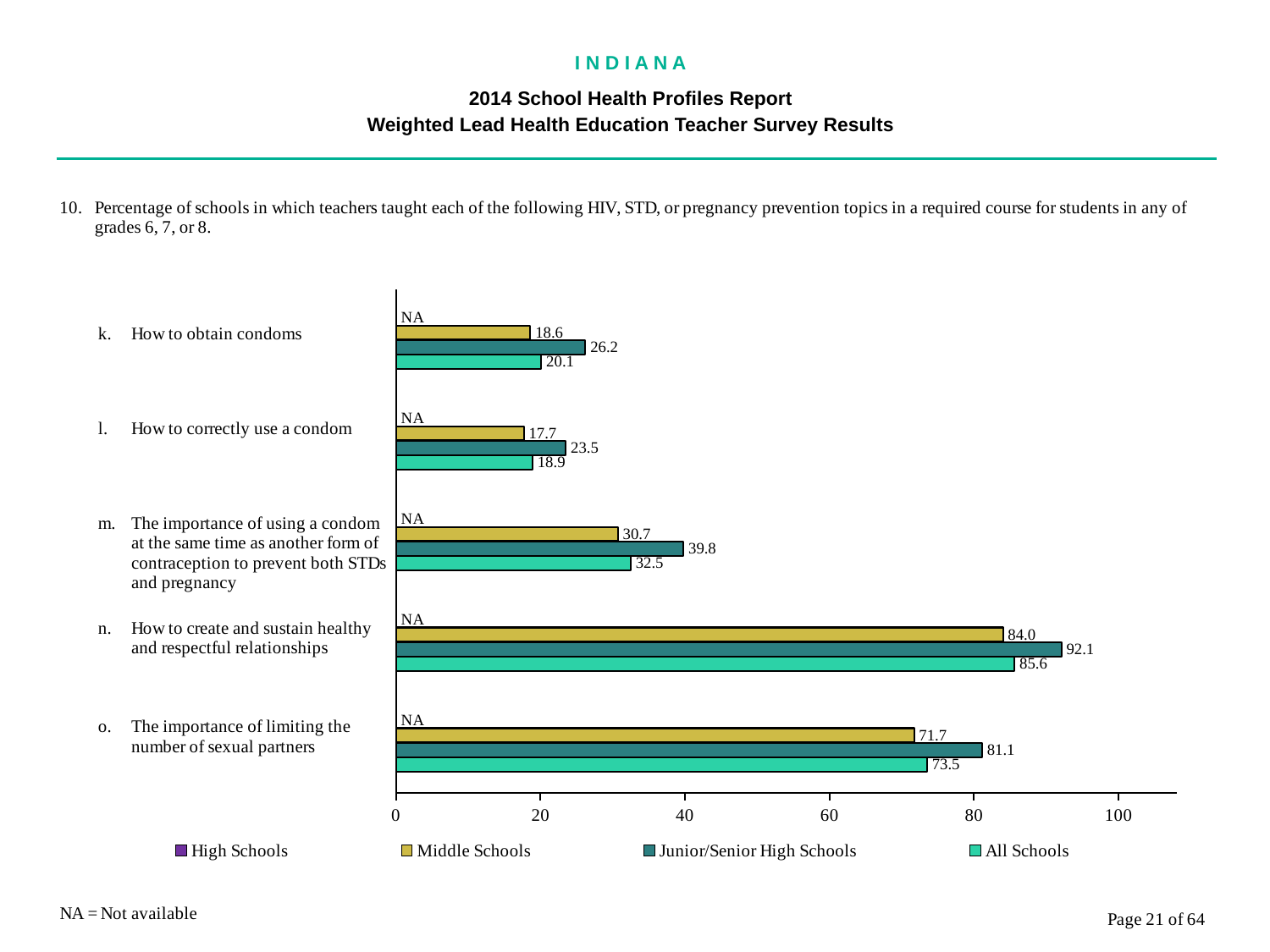
What is the Junior/Senior High Schools value for 'How to create and sustain healthy and respectful relationships'? 92.1 Which topic has the lowest Middle Schools value? How to correctly use a condom What is the Middle Schools value for 'How to obtain condoms'? 18.6 Which topic has the highest All Schools value? How to create and sustain healthy and respectful relationships How many series does the legend list? 4 What is the All Schools value for 'The importance of limiting the number of sexual partners'? 73.5 How many topics are plotted on the chart? 5 Which series is shown in yellow in the legend? Middle Schools What is the High Schools value for 'How to correctly use a condom'? NA What is the difference between the Junior/Senior High Schools and Middle Schools values for 'The importance of limiting the number of sexual partners'? 9.4 For 'The importance of using a condom at the same time as another form of contraception to prevent both STDs and pregnancy', which is larger: the Middle Schools value or the All Schools value? All Schools What kind of chart is shown on the slide? bar chart